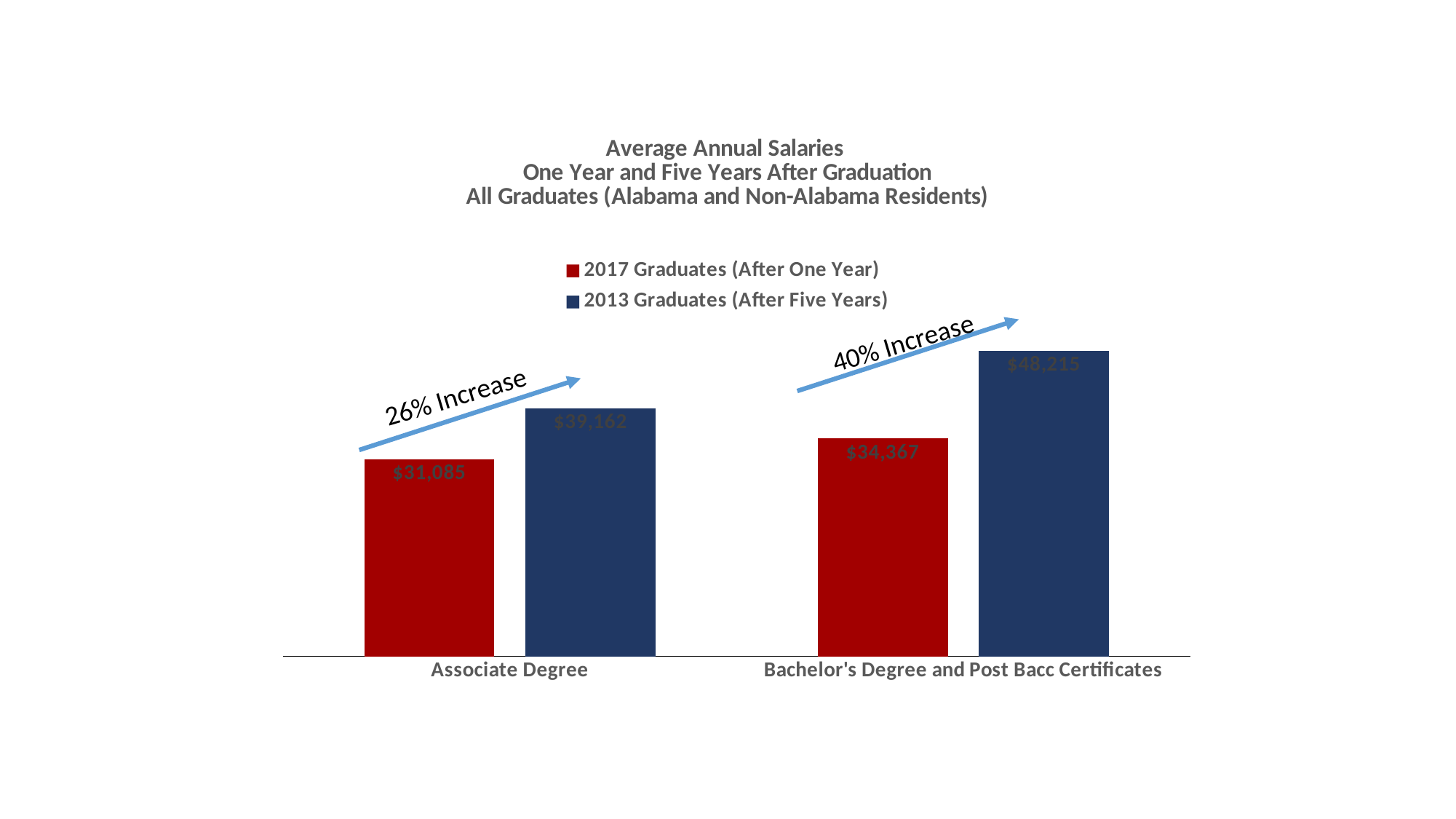
Which bar shows the highest average annual salary? 2013 Graduates (After Five Years), Bachelor's Degree and Post Bacc Certificates What is the difference between the five-year and one-year salaries for Bachelor's Degree and Post Bacc Certificates graduates? $13,848 What is the average annual salary for 2017 Graduates (After One Year) with an Associate Degree? $31,085 Which is larger: the one-year salary for Bachelor's Degree and Post Bacc Certificates or the five-year salary for Associate Degree? Five-year salary for Associate Degree What is the average annual salary for 2013 Graduates (After Five Years) with a Bachelor's Degree and Post Bacc Certificates? $48,215 Which bar shows the lowest average annual salary? 2017 Graduates (After One Year), Associate Degree What is the average annual salary for 2013 Graduates (After Five Years) with an Associate Degree? $39,162 What is the difference between the five-year and one-year salaries for Associate Degree graduates? $8,077 How many series does the legend list? 2 How many degree categories are shown on the x axis? 2 What percentage increase is annotated above the Bachelor's Degree and Post Bacc Certificates bars? 40% Increase What is the average annual salary for 2017 Graduates (After One Year) with a Bachelor's Degree and Post Bacc Certificates? $34,367